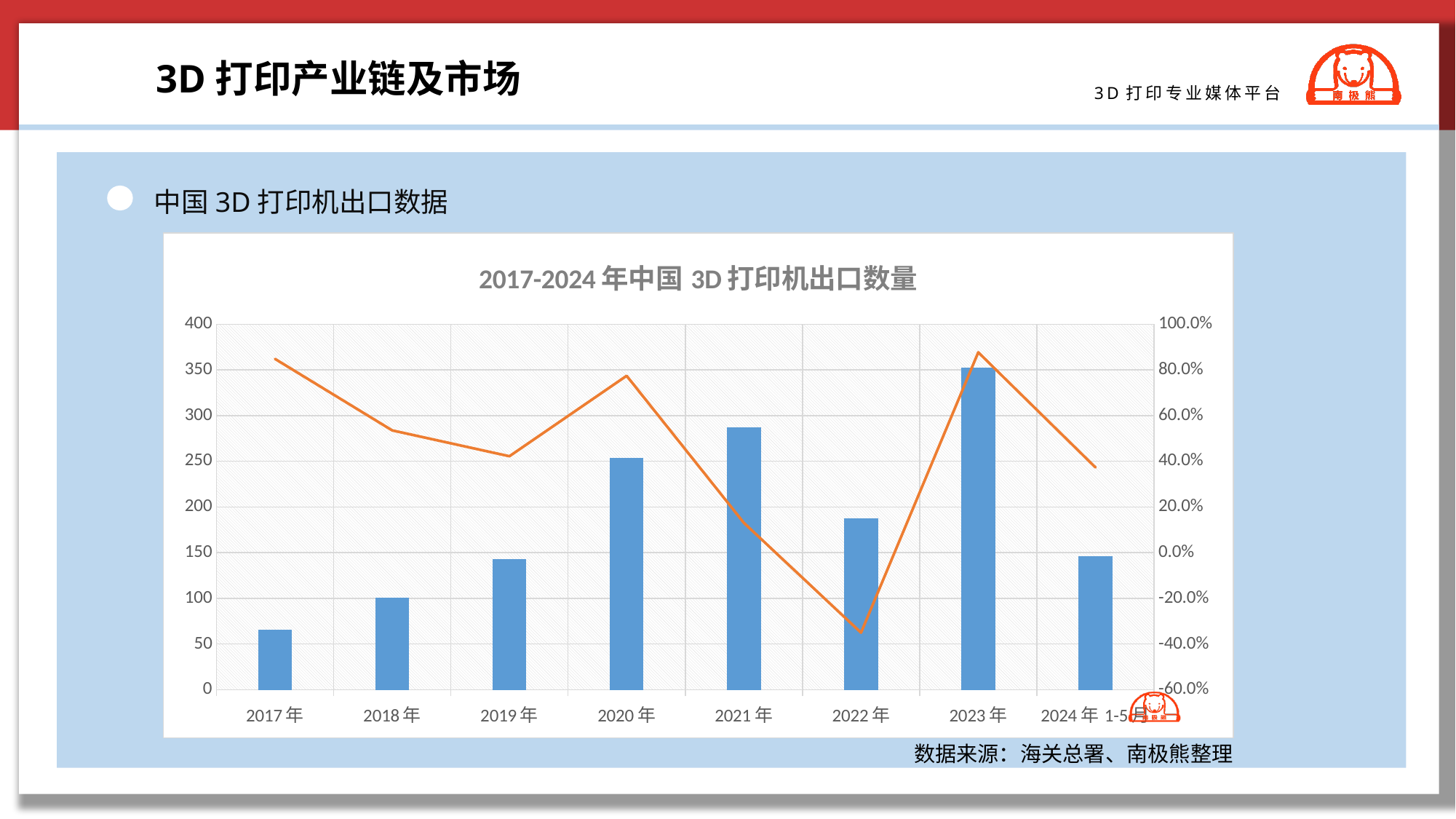
Is the line value for 2022 年 greater or less than 0.0%? less Is the bar value for 2021 年 greater or less than 250? greater Which year has the shortest bar? 2017 年 Does the line rise or fall from 2020 年 to 2022 年? fall Is the bar value for 2022 年 greater or less than 200? less How many year categories are shown on the x axis? 8 Which year has the tallest bar? 2023 年 Which bar is taller, 2020 年 or 2021 年? 2021 年 What kind of chart is shown on the slide? A combined bar and line chart What is the title of the chart? 2017-2024 年中国 3D 打印机出口数量